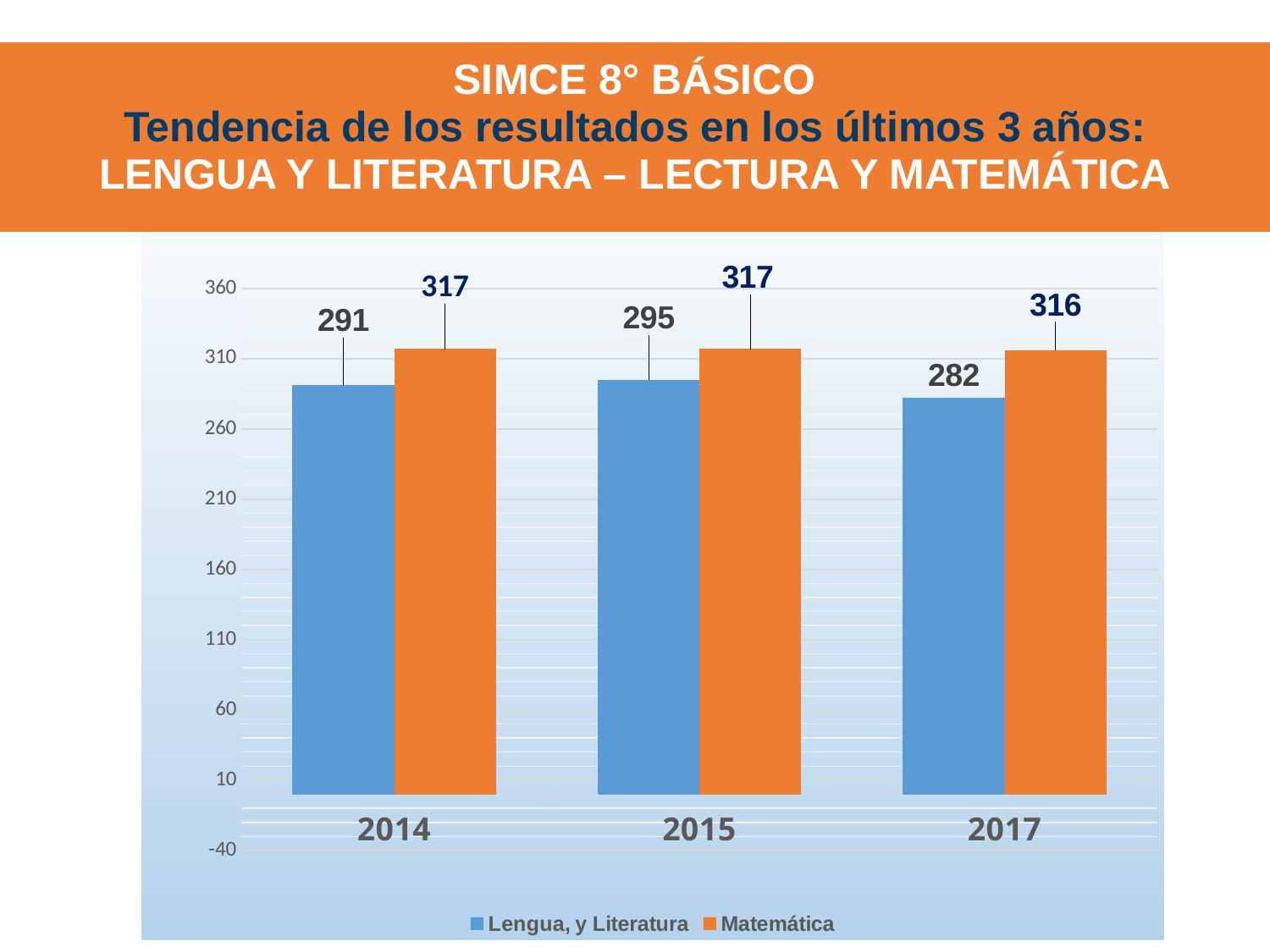
What was the Lengua y Literatura score in 2014? 291 In which year was the Lengua y Literatura score highest? 2015 What is the difference between the Matemática and Lengua y Literatura scores in 2017? 34 In which year was the Lengua y Literatura score lowest? 2017 Which colour represents Matemática in the chart? Orange What kind of chart is shown on the slide? Bar chart How many years are shown on the x axis? 3 What was the Matemática score in 2017? 316 Which was higher in 2015, Lengua y Literatura or Matemática? Matemática What was the Lengua y Literatura score in 2017? 282 By how much did the Lengua y Literatura score change from 2015 to 2017? 13 How many series does the legend list? 2